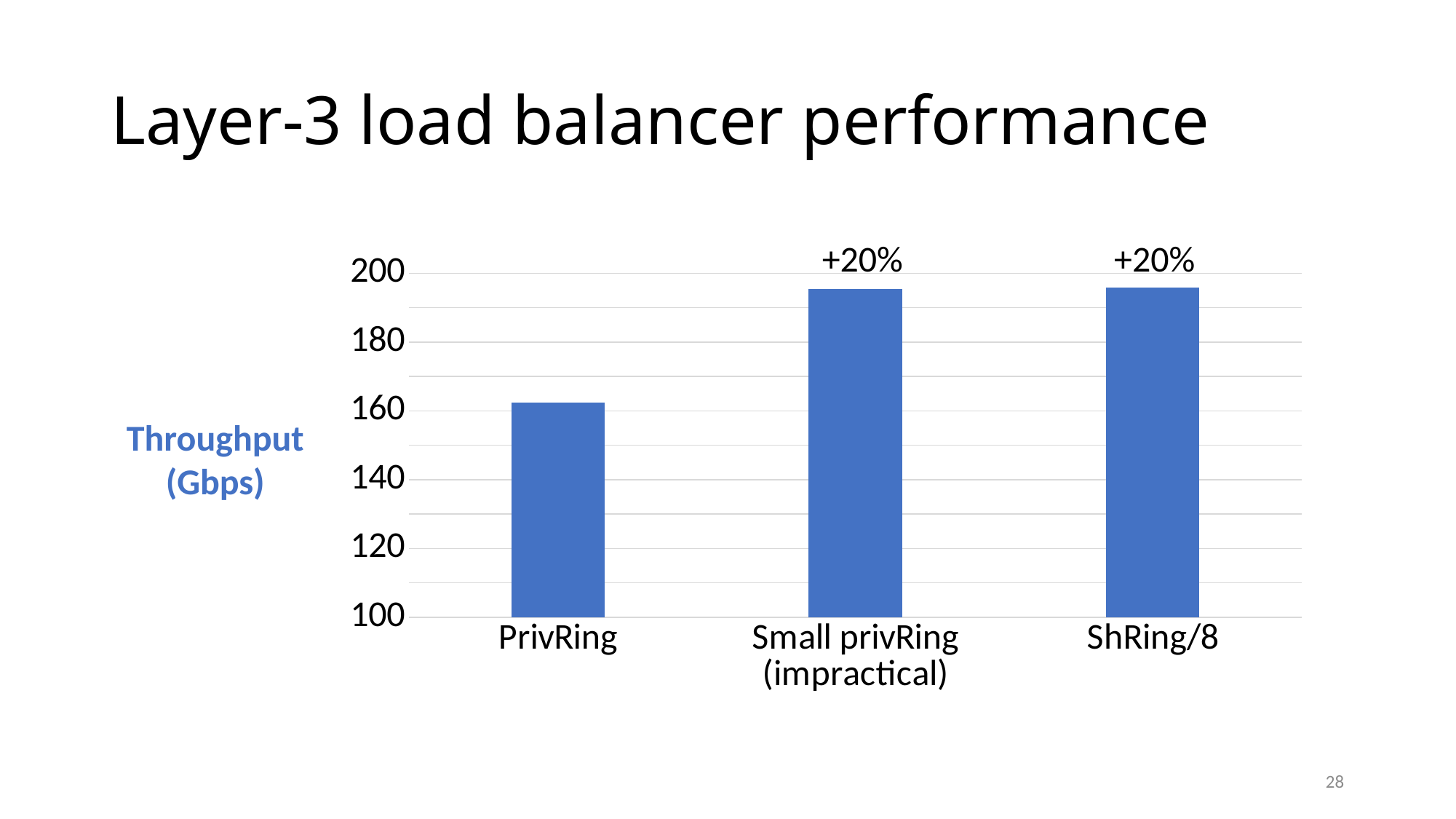
Which category has the lowest throughput? PrivRing Is the value for Small privRing (impractical) greater or less than 200? less Is the value for PrivRing greater or less than 180? less What is the label of the vertical axis? Throughput (Gbps) Which is larger, the value for Small privRing (impractical) or the value for PrivRing? Small privRing (impractical) What kind of chart is shown on the slide? bar chart What annotation is printed above the ShRing/8 bar? +20% Which is larger, the value for PrivRing or the value for ShRing/8? ShRing/8 Is the value for PrivRing greater or less than 140? greater How many categories are plotted on the chart? 3